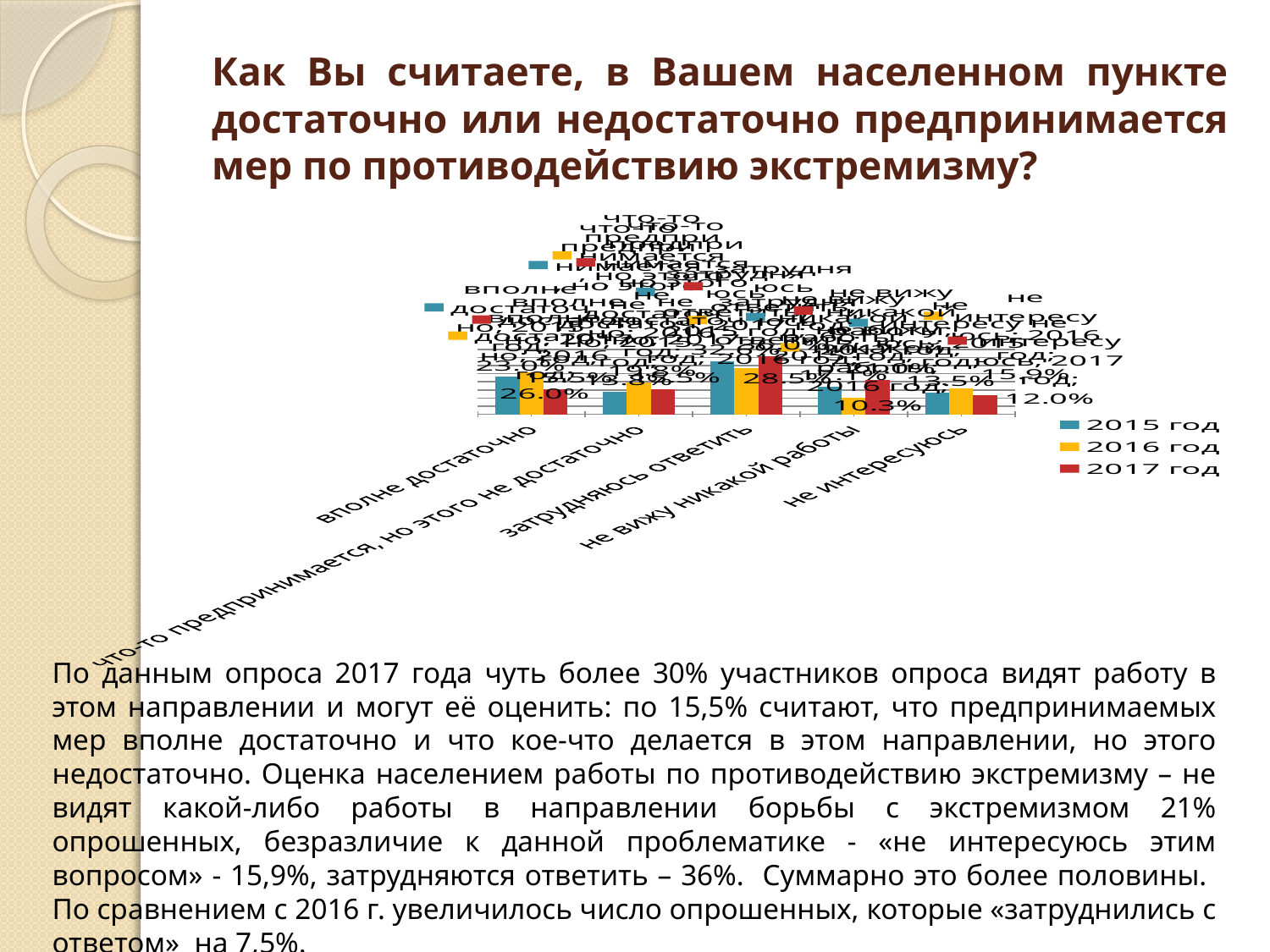
Which category has the tallest bars overall in the chart? затрудняюсь ответить For the 2015 год series, which category has the tallest bar? затрудняюсь ответить Which years are listed in the chart legend? 2015 год, 2016 год, 2017 год Which colour represents the 2017 год series in the chart? red What kind of chart is shown on the slide? bar chart How many categories are shown along the x axis of the chart? 5 For the 2016 год series, which is larger: затрудняюсь ответить or не вижу никакой работы? затрудняюсь ответить How many series does the chart legend list? 3 For the 2017 год series, which is larger: затрудняюсь ответить or не интересуюсь? затрудняюсь ответить